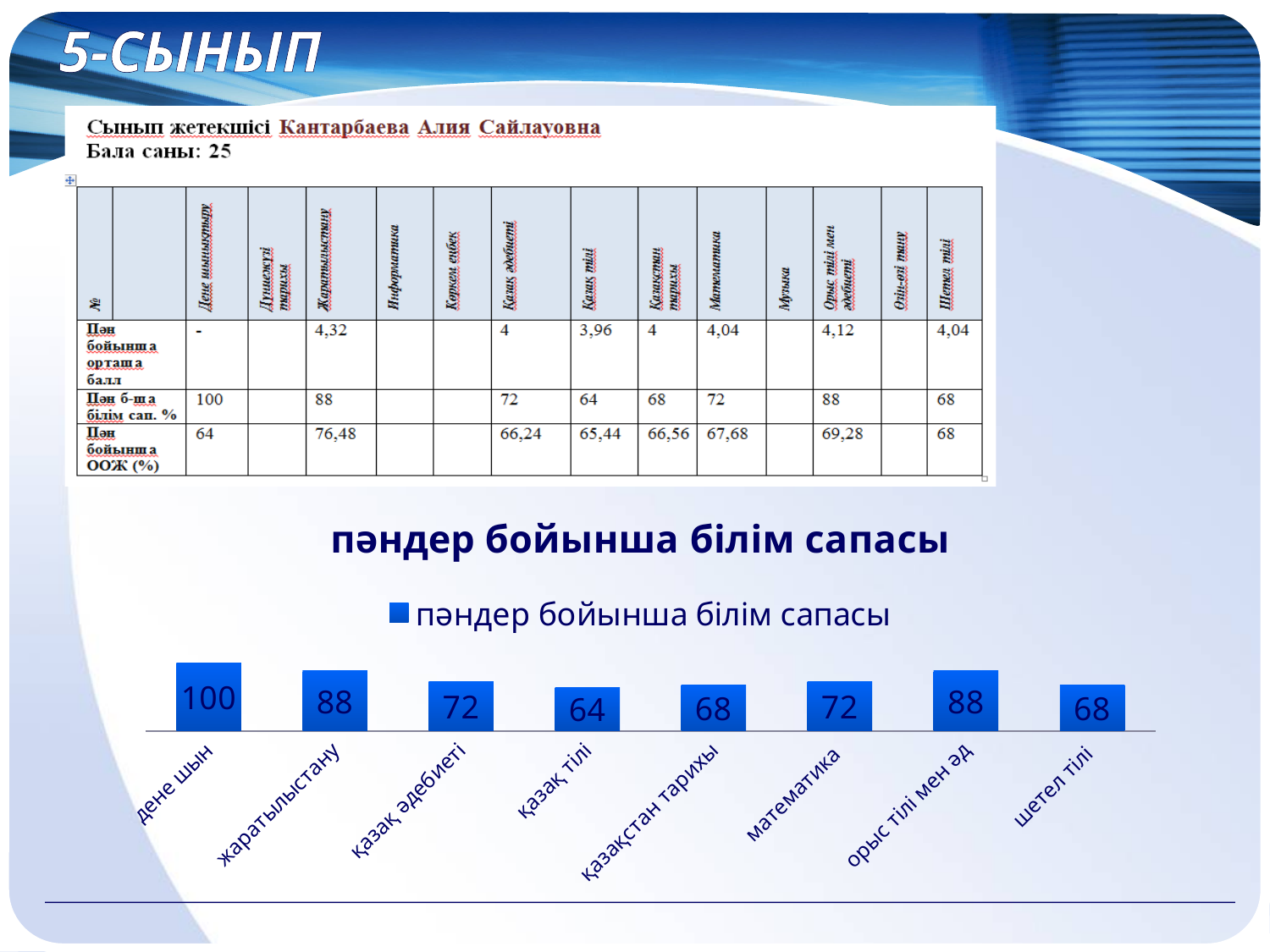
What is the title of the chart? пәндер бойынша білім сапасы What is the value for жаратылыстану in the chart? 88 Which is larger, the value for жаратылыстану or the value for қазақстан тарихы? жаратылыстану What is the value for дене шын in the chart? 100 Which category has the lowest value in the chart? қазақ тілі What is the difference between the values for орыс тілі мен әд and қазақ әдебиеті? 16 Which category has the highest value in the chart? дене шын What is the value for математика in the chart? 72 What is the difference between the values for дене шын and қазақ тілі? 36 How many categories are shown in the chart? 8 What kind of chart is shown on the slide? bar chart What is the value for шетел тілі in the chart? 68